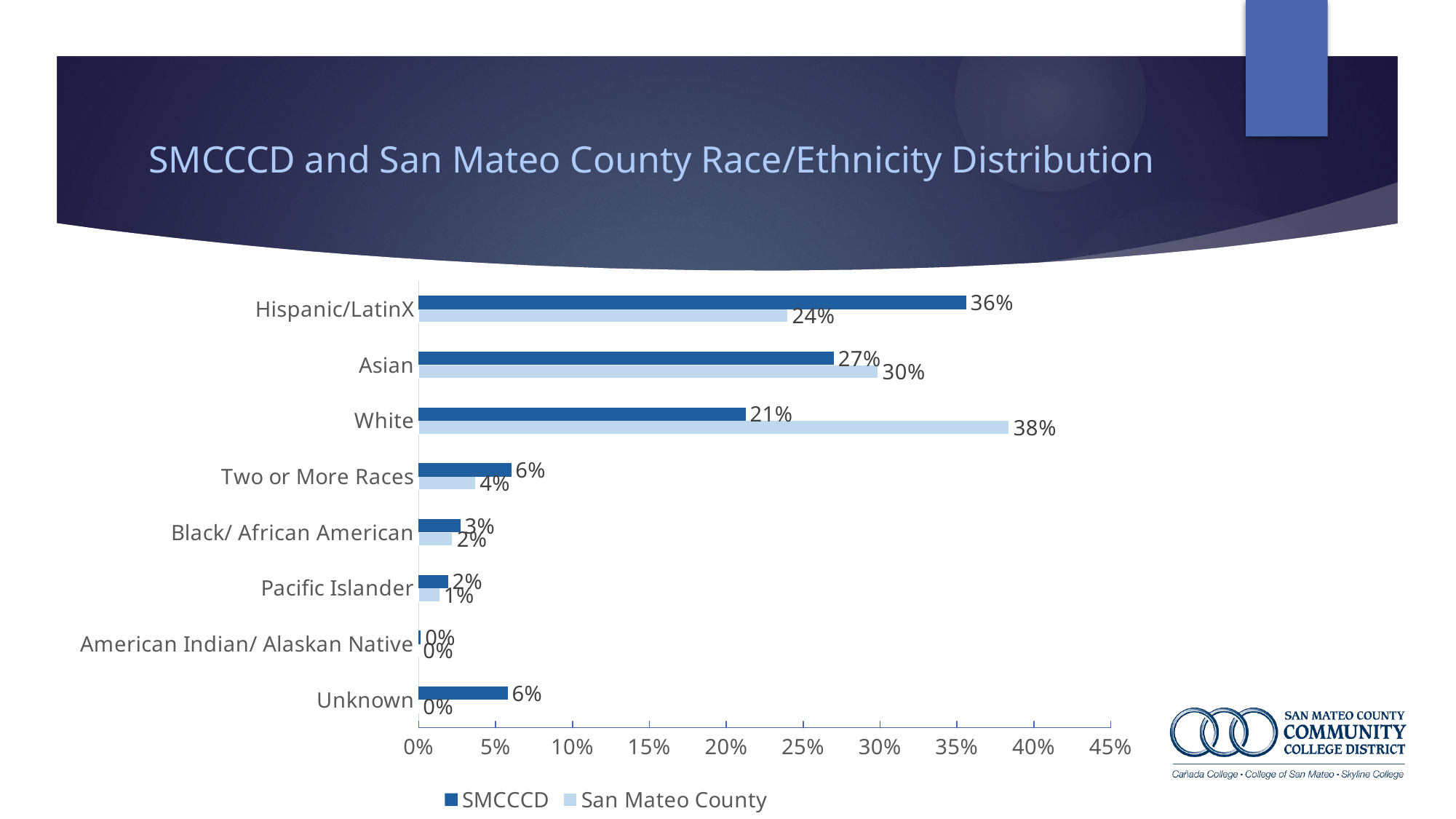
What kind of chart is shown on the slide? Bar chart What is the San Mateo County value for Asian? 30% What is the SMCCCD value for Unknown? 6% Which is larger for Asian: the SMCCCD value or the San Mateo County value? San Mateo County Which category has the highest San Mateo County value? White What is the SMCCCD value for Hispanic/LatinX? 36% How many race/ethnicity categories are shown on the chart? 8 How many series does the legend list? 2 Which category has the highest SMCCCD value? Hispanic/LatinX What is the San Mateo County value for White? 38% What is the difference between the SMCCCD and San Mateo County values for Hispanic/LatinX? 12% What is the difference between the San Mateo County and SMCCCD values for White? 17%